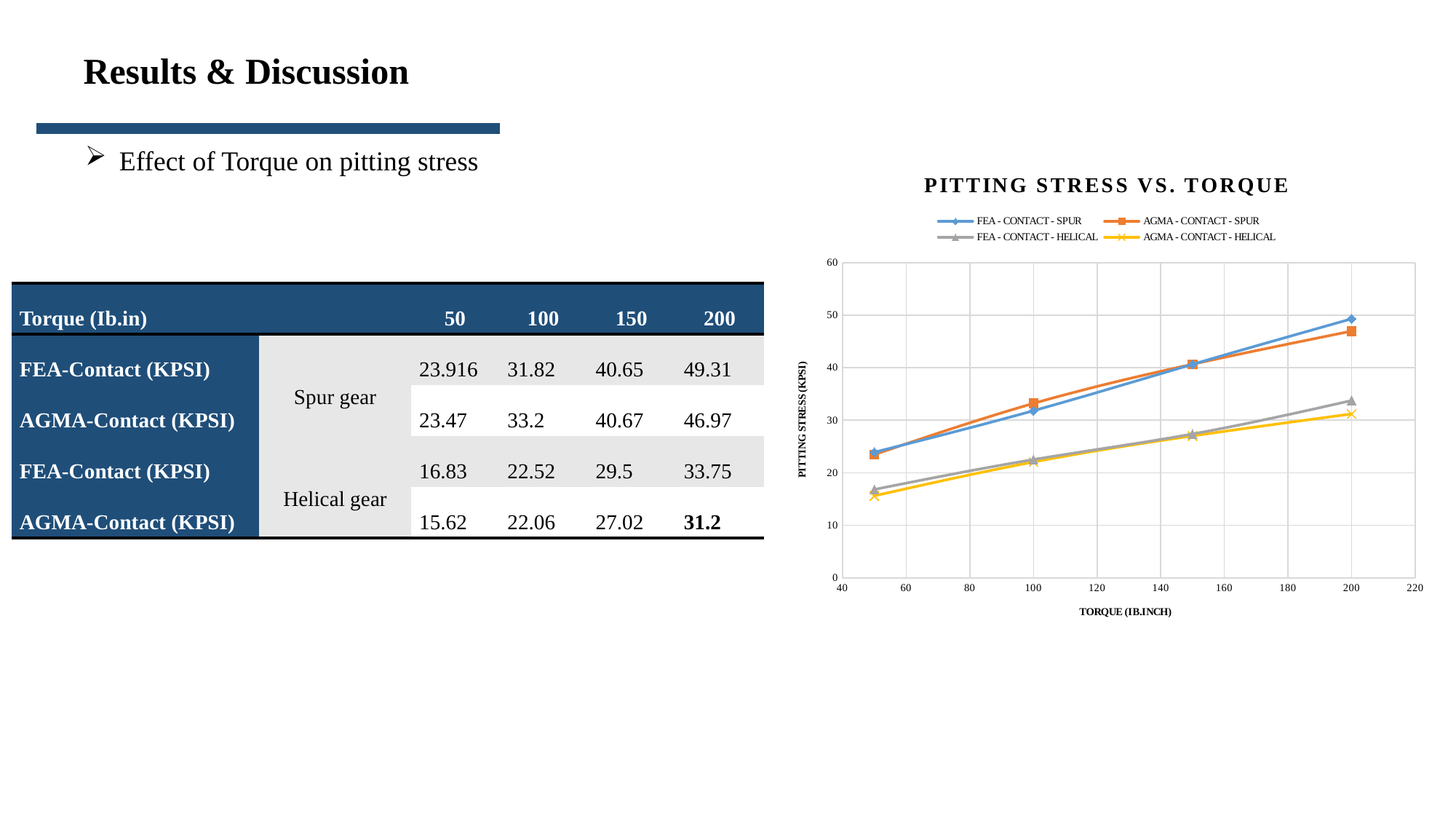
What kind of chart is shown under the title "PITTING STRESS VS. TORQUE"? line chart How many torque values are plotted for each series in the "PITTING STRESS VS. TORQUE" chart? 4 In the "PITTING STRESS VS. TORQUE" chart, which is larger at a torque of 100: AGMA - CONTACT - SPUR or FEA - CONTACT - SPUR? AGMA - CONTACT - SPUR In the "PITTING STRESS VS. TORQUE" chart, which series has the lowest pitting stress at a torque of 200? AGMA - CONTACT - HELICAL What is the pitting stress for FEA - CONTACT - SPUR at a torque of 200 in the "PITTING STRESS VS. TORQUE" chart? 49.31 In the "PITTING STRESS VS. TORQUE" chart, is the value for FEA - CONTACT - SPUR at a torque of 200 greater or less than 40? greater In the "PITTING STRESS VS. TORQUE" chart, is the value for AGMA - CONTACT - HELICAL at a torque of 50 greater or less than 20? less How many series does the legend of the "PITTING STRESS VS. TORQUE" chart list? 4 What is the x-axis title of the "PITTING STRESS VS. TORQUE" chart? TORQUE (IB.INCH) In the "PITTING STRESS VS. TORQUE" chart, do the pitting stress values rise or fall as torque increases? rise In the "PITTING STRESS VS. TORQUE" chart, which series has the highest pitting stress at a torque of 200? FEA - CONTACT - SPUR In the "PITTING STRESS VS. TORQUE" chart, what is the difference between FEA - CONTACT - SPUR and AGMA - CONTACT - SPUR at a torque of 200? 2.34